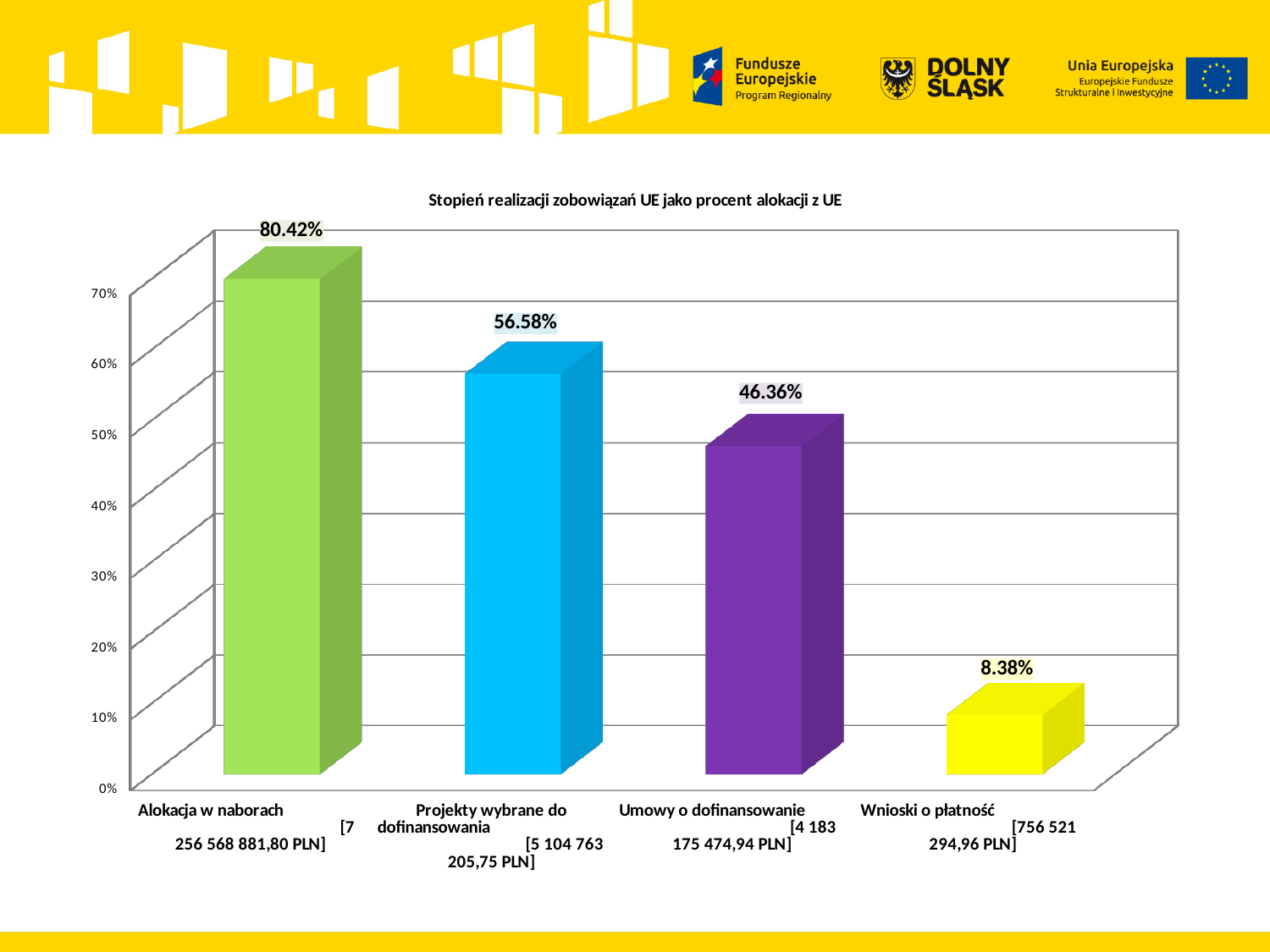
Which is larger, the value for Projekty wybrane do dofinansowania or the value for Umowy o dofinansowanie? Projekty wybrane do dofinansowania What is the value shown for Umowy o dofinansowanie? 46.36% What is the difference between the values for Umowy o dofinansowanie and Wnioski o płatność? 37.98% Which category has the highest value? Alokacja w naborach Which category has the lowest value? Wnioski o płatność What is the value shown for Wnioski o płatność? 8.38% What is the value shown for Projekty wybrane do dofinansowania? 56.58% What is the value shown for Alokacja w naborach? 80.42% How many categories are shown in the chart? 4 What is the difference between the values for Alokacja w naborach and Projekty wybrane do dofinansowania? 23.84% What kind of chart is shown on the slide? Bar chart What is the title of the chart? Stopień realizacji zobowiązań UE jako procent alokacji z UE